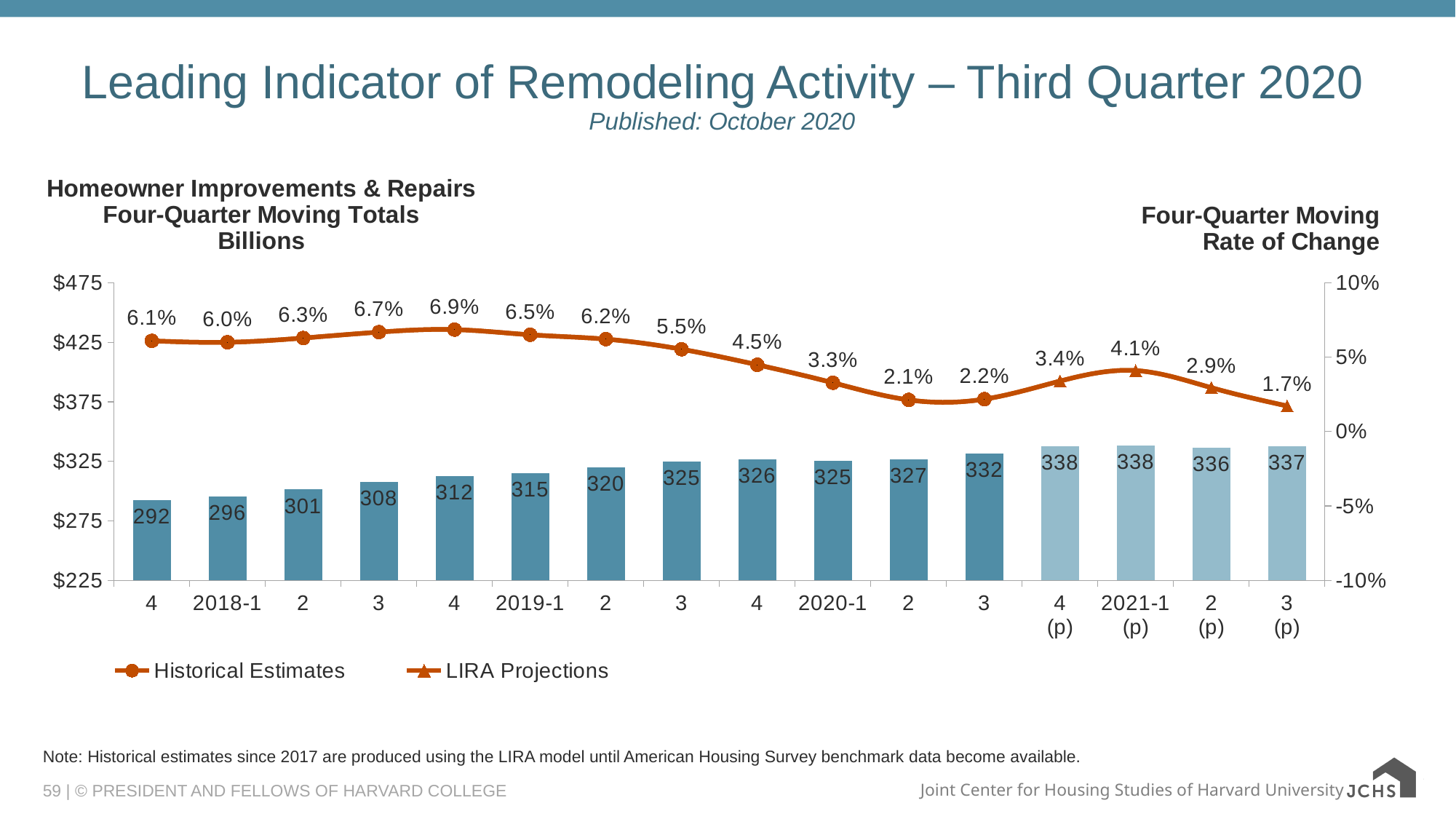
Does the four-quarter moving rate of change rise or fall from 2018-4 to 2020-2? Fall What is the four-quarter moving rate of change for 2019-1? 6.5% By how much does the four-quarter moving total for 2020-3 exceed that for 2020-2? 5 What is the projected four-quarter moving total for 2021-1 (p)? 338 What is the difference in the rate of change between 2019-4 (4.5%) and 2020-1 (3.3%)? 1.2 percentage points What is the highest four-quarter moving rate of change shown on the line? 6.9% Which has the larger four-quarter moving total, 2019-3 or 2019-4? 2019-4 What kind of chart is shown on the slide? Combination bar and line chart What is the four-quarter moving total (billions) for 2020-1? 325 How many quarters (bars) are plotted on the chart? 16 How many series does the legend list? 2 Which quarter has the lowest four-quarter moving rate of change? 2021-3 (p), at 1.7%